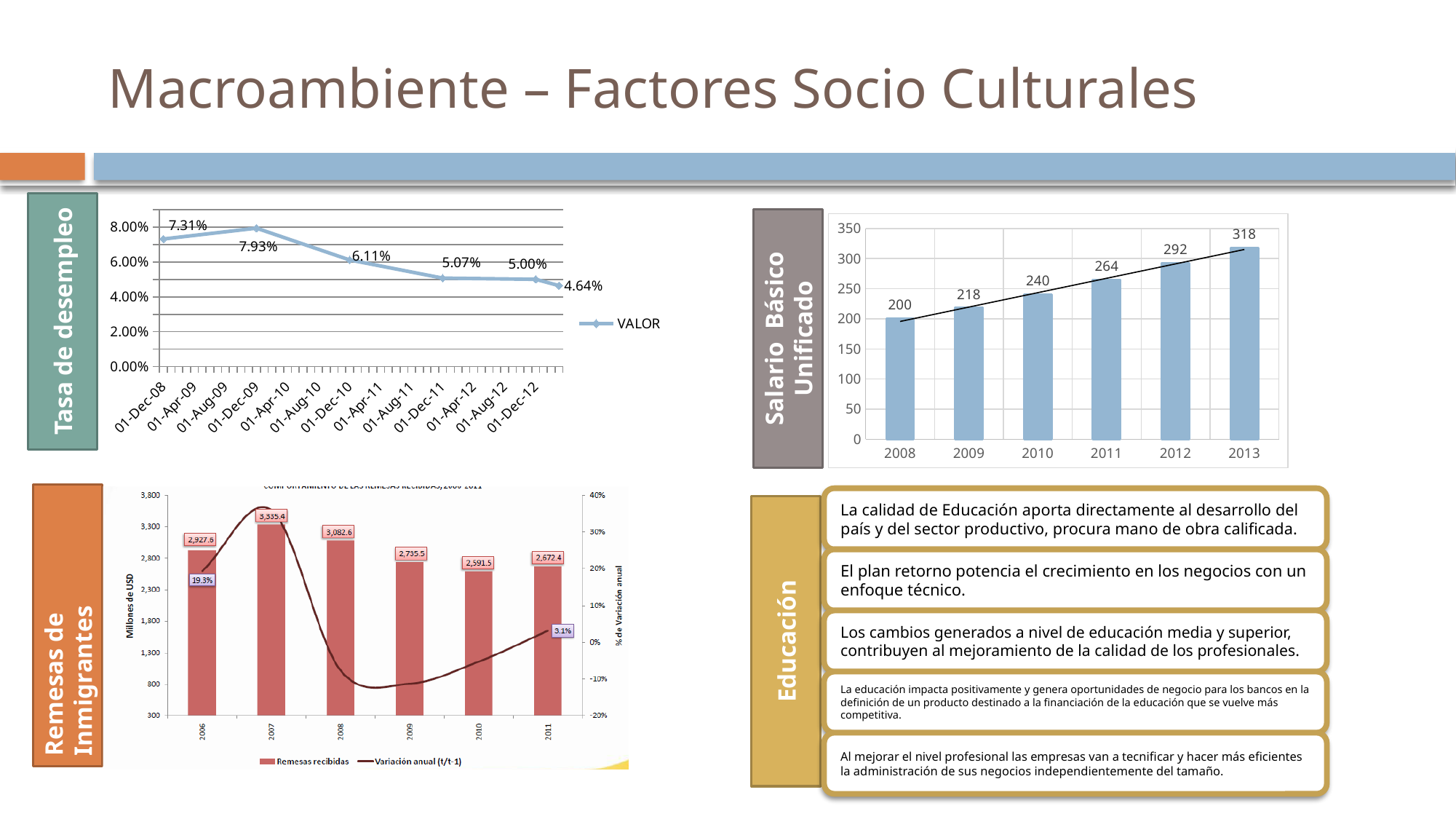
In the Remesas de Inmigrantes chart, how many series does the legend list? 2 In the Salario Básico Unificado chart, what is the value for 2013? 318 In the Tasa de desempleo chart, what series name does the legend show? VALOR What kind of chart is the Salario Básico Unificado chart? bar chart In the Salario Básico Unificado chart, what is the value for 2010? 240 In the Salario Básico Unificado chart, what is the difference between the 2013 and 2008 values? 118 In the Remesas de Inmigrantes chart, what is the remittances value for 2011? 2,672.4 In the Remesas de Inmigrantes chart, which year has the highest remittances bar? 2007 In the Salario Básico Unificado chart, how many years are shown on the x axis? 6 In the Tasa de desempleo chart, what is the highest labelled value? 7.93% In the Salario Básico Unificado chart, do the values rise or fall from 2008 to 2013? rise